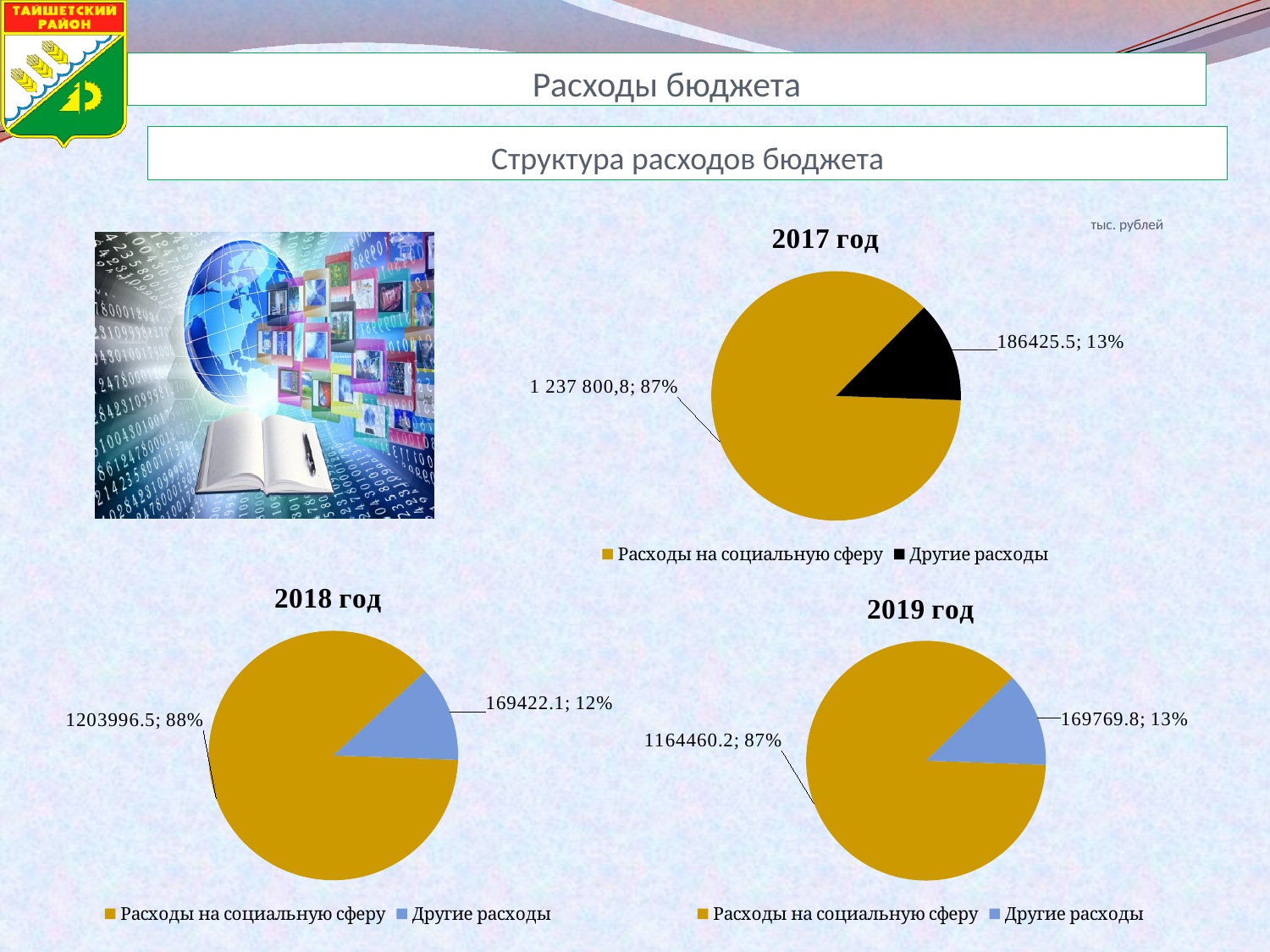
In the "2018 год" chart, which category is the smallest? Другие расходы In the "2017 год" chart, what is the value shown for Расходы на социальную сферу? 1 237 800,8; 87% In the "2019 год" chart, what is the value shown for Другие расходы? 169769.8; 13% In the "2017 год" chart, which category is the largest? Расходы на социальную сферу How many series does the legend of the "2017 год" chart list? 2 What type of chart is the "2019 год" chart? Pie chart In the "2018 год" chart, what is the value shown for Другие расходы? 169422.1; 12% In the "2019 год" chart, what share of the pie does Расходы на социальную сферу take? 87% In the "2019 год" chart, what is the value shown for Расходы на социальную сферу? 1164460.2; 87% In the "2017 год" chart, what is the value shown for Другие расходы? 186425.5; 13% In the "2018 год" chart, what is the value shown for Расходы на социальную сферу? 1203996.5; 88% In the "2018 год" chart, what share of the pie does Другие расходы take? 12%